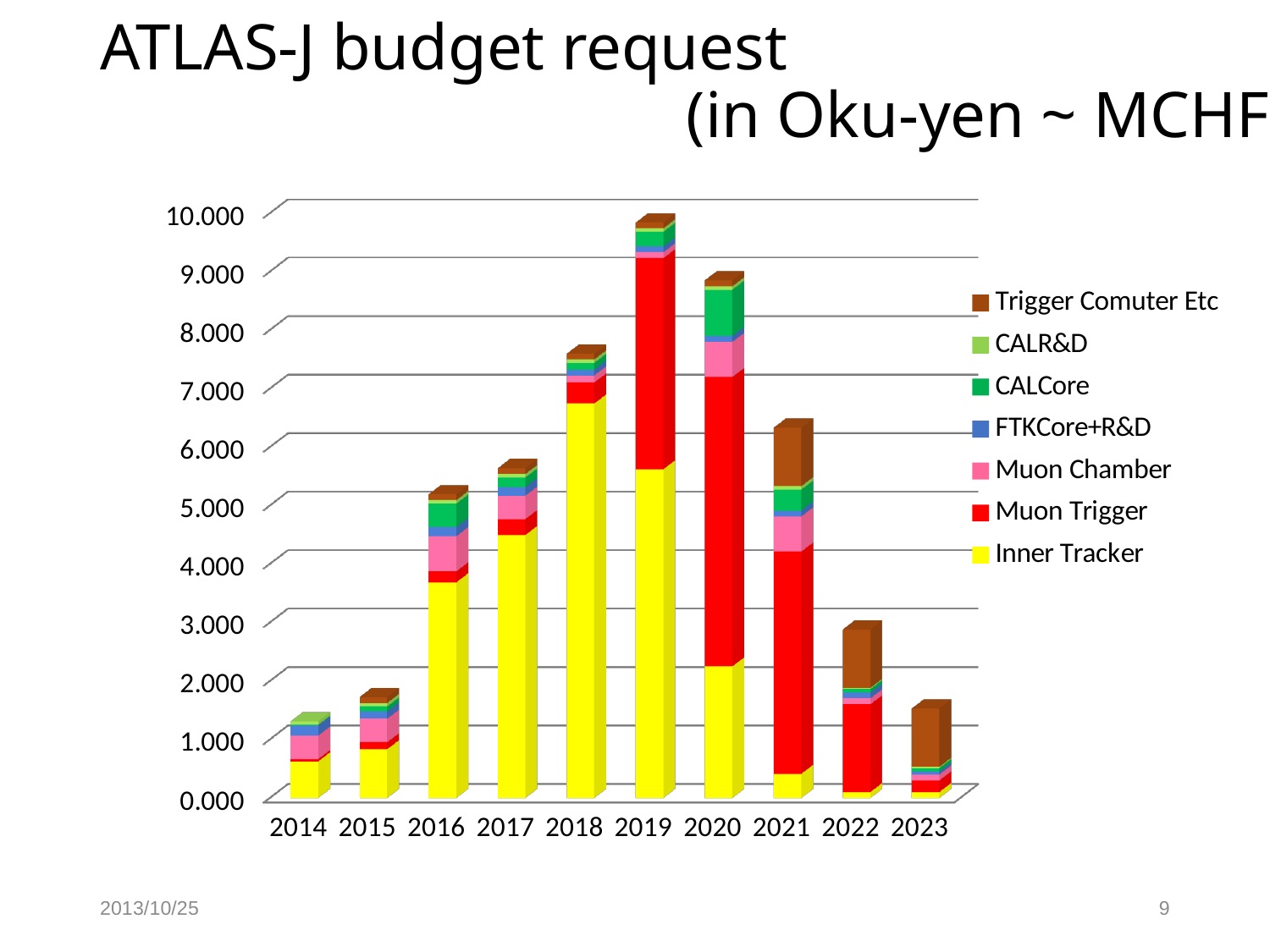
What kind of chart is shown on the slide? stacked bar chart Is the total for 2018 greater or less than 7.000? greater How many series does the legend list? 7 Is the total for 2019 greater or less than 9.000? greater Which year has the larger total, 2019 or 2020? 2019 Is the total for 2014 greater or less than 2.000? less Which series makes up the largest part of the 2020 bar? Muon Trigger What colour represents Inner Tracker in the legend? yellow Do the bar totals rise or fall from 2014 to 2019? rise Which year has the tallest stacked bar? 2019 How many years are shown on the x axis of the chart? 10